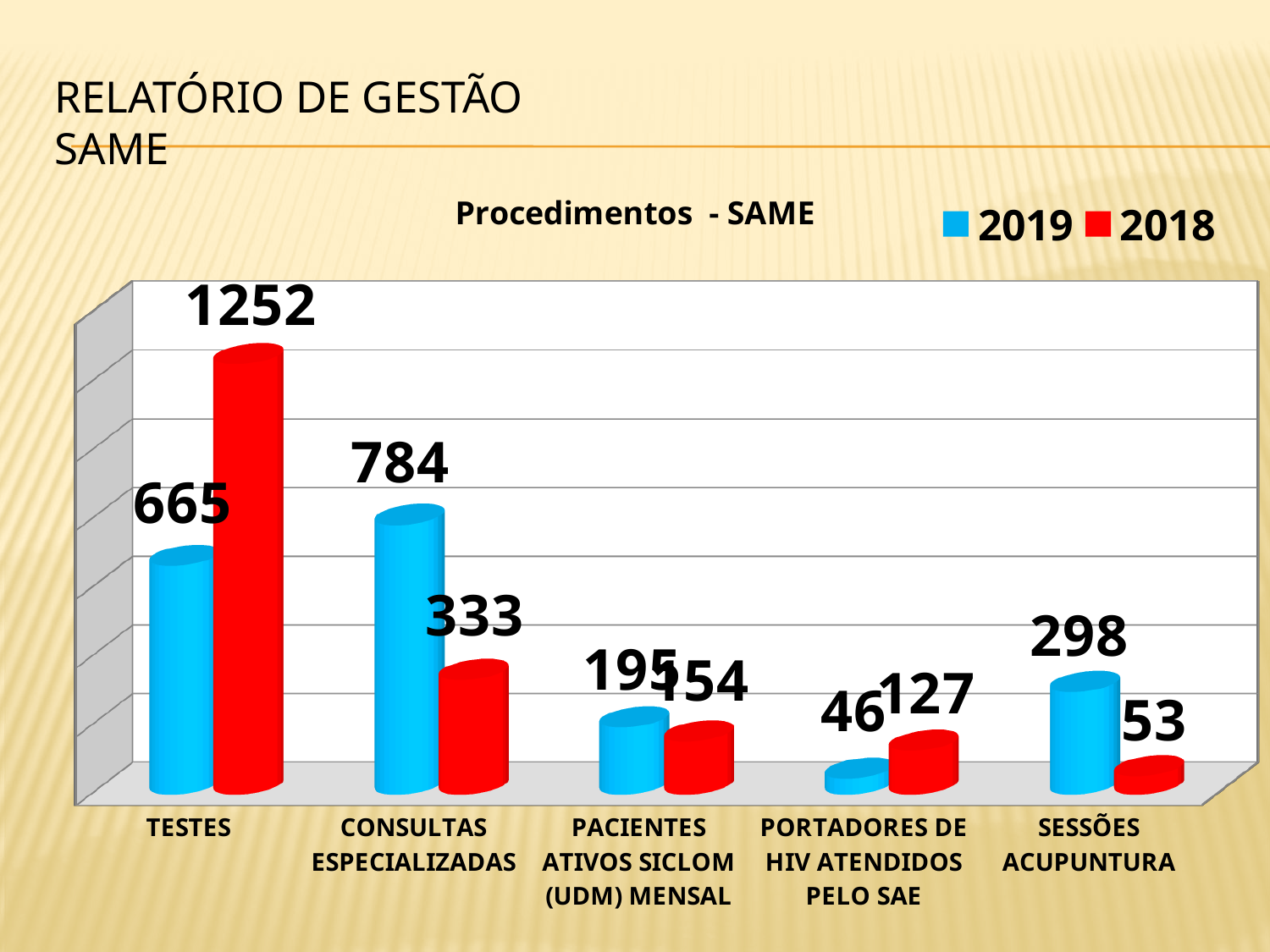
How many categories are shown on the x axis? 5 What is the difference between the 2019 and 2018 values for SESSÕES ACUPUNTURA? 245 What type of chart is shown on the slide? Bar chart What is the value for SESSÕES ACUPUNTURA in 2018? 53 What is the value for CONSULTAS ESPECIALIZADAS in 2019? 784 What is the difference between the 2018 and 2019 values for TESTES? 587 Which category has the highest value in the 2019 series? CONSULTAS ESPECIALIZADAS For PACIENTES ATIVOS SICLOM (UDM) MENSAL, which year has the larger value, 2019 or 2018? 2019 How many series does the legend list? 2 What is the value for TESTES in 2018? 1252 Which category has the lowest value in the 2018 series? SESSÕES ACUPUNTURA What is the value for PORTADORES DE HIV ATENDIDOS PELO SAE in 2019? 46